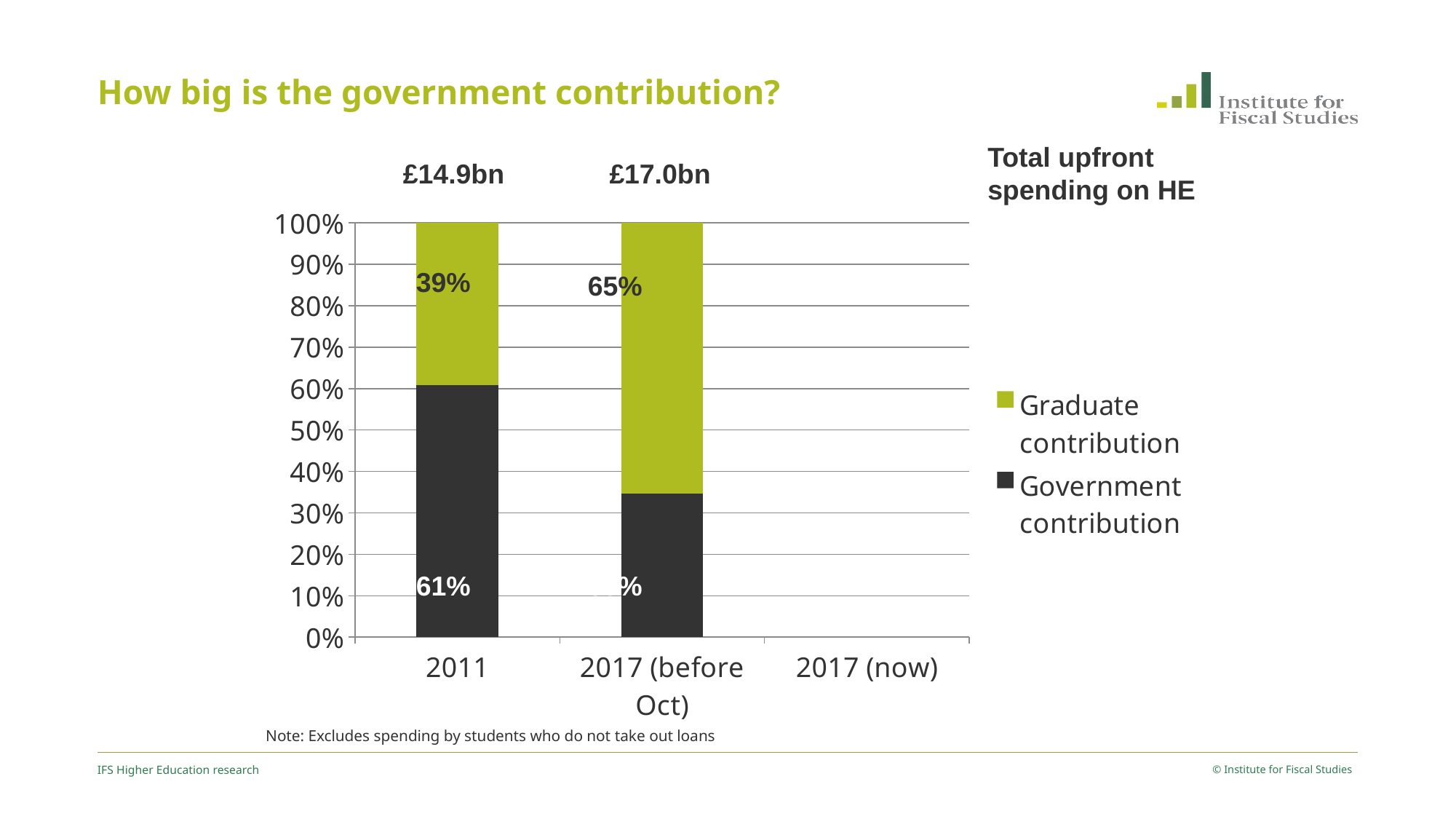
In 2011, how many percentage points larger is the Government contribution than the Graduate contribution? 22 percentage points What is the Graduate contribution share for 2011? 39% Is the Government contribution share for 2017 (before Oct) greater or less than 40%? less What is the total upfront spending on HE shown above the 2011 bar? £14.9bn What is the total upfront spending on HE shown above the 2017 (before Oct) bar? £17.0bn Does the Government contribution share rise or fall from 2011 to 2017 (before Oct)? fall How many series does the legend list? 2 Which year has the larger Graduate contribution share, 2011 or 2017 (before Oct)? 2017 (before Oct) What is the Government contribution share for 2011? 61% What kind of chart is shown on the slide? Stacked bar chart What is the Graduate contribution share for 2017 (before Oct)? 65% How many categories are shown on the x axis? 3